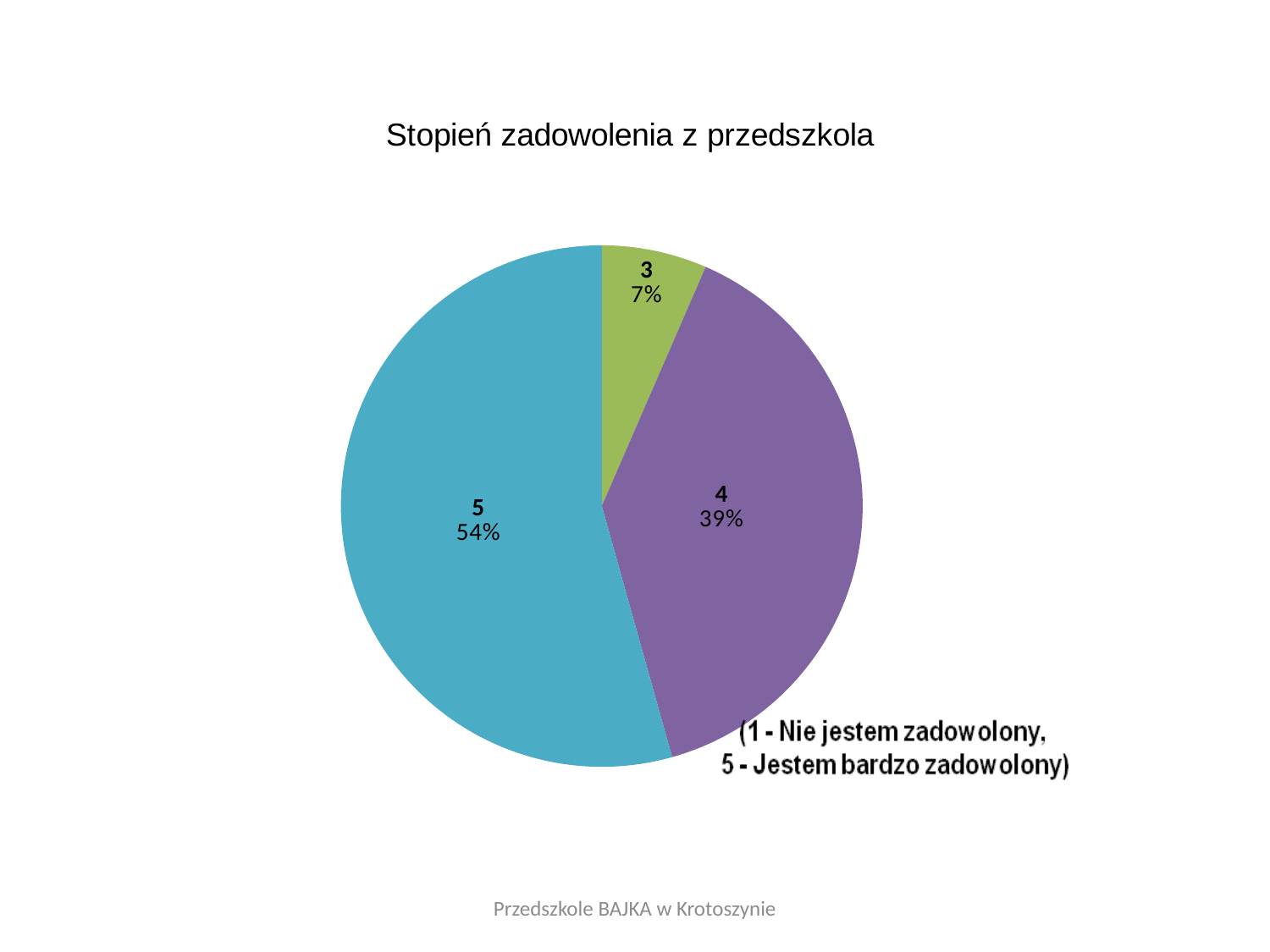
What colour is the slice for rating 4? purple Which slice is larger, rating 4 or rating 3? 4 How many slices does the pie chart have? 3 What share of the pie does rating 5 represent? 54% What is the difference in percentage points between the slices for rating 5 and rating 4? 15% What share of the pie does rating 3 represent? 7% What is the difference in percentage points between the slices for rating 4 and rating 3? 32% Which rating has the smallest slice of the pie? 3 Which rating has the largest slice of the pie? 5 What share of the pie does rating 4 represent? 39% What kind of chart is shown on the slide? pie chart What is the title of the chart? Stopień zadowolenia z przedszkola